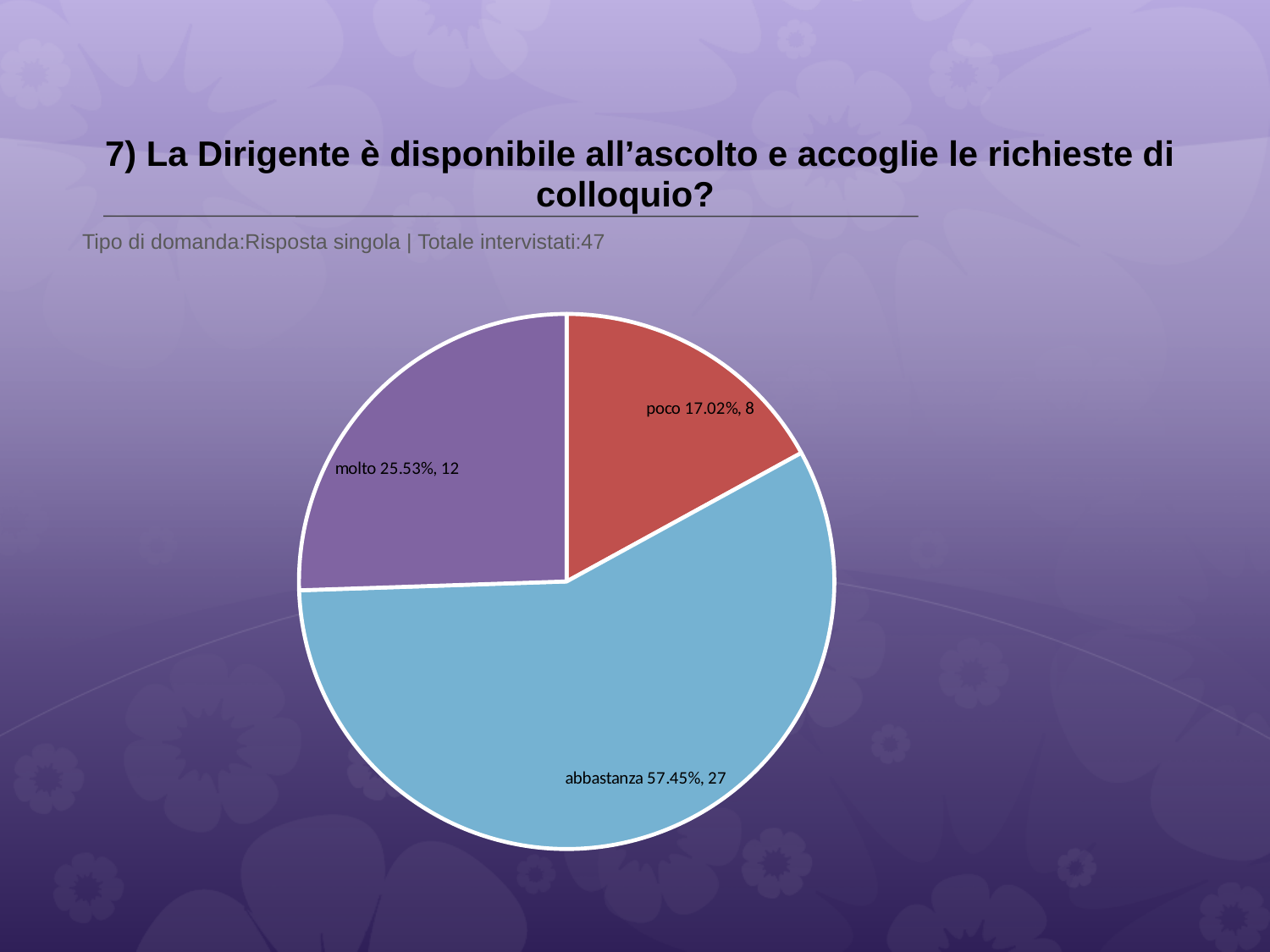
What percentage share does the 'abbastanza' slice have? 57.45% Which response has the largest slice of the pie? abbastanza Which response has the smallest slice of the pie? poco Which has more respondents, 'molto' or 'poco'? molto How many respondents answered 'poco'? 8 How many respondents answered 'molto'? 12 How many slices does the pie chart have? 3 What percentage share does the 'poco' slice have? 17.02% What kind of chart is shown on the slide? pie chart What percentage share does the 'molto' slice have? 25.53% How many respondents answered 'abbastanza'? 27 What is the difference in the number of respondents between 'abbastanza' and 'molto'? 15